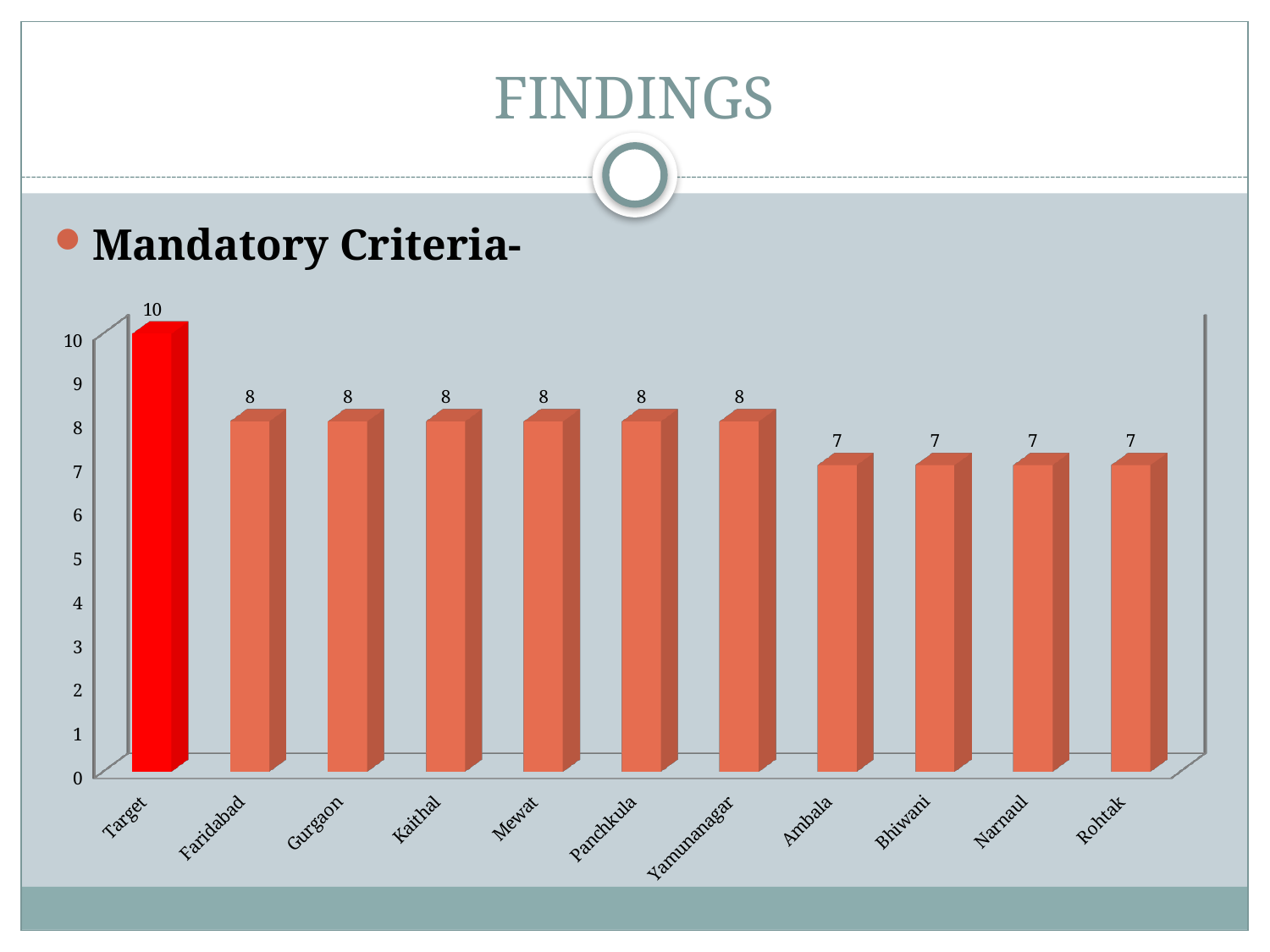
How many categories are shown on the x axis? 11 What is the value for Rohtak? 7 What is the value for Target? 10 What kind of chart is shown on the slide? bar chart Which is larger, the value for Kaithal or the value for Narnaul? Kaithal What is the value for Faridabad? 8 Which category has the highest value? Target What is the difference between the value for Target and the value for Gurgaon? 2 What is the value for Ambala? 7 Do the values rise or fall from Target to Rohtak along the x axis? fall What is the difference between the value for Mewat and the value for Bhiwani? 1 Which bar is coloured differently from the others? Target